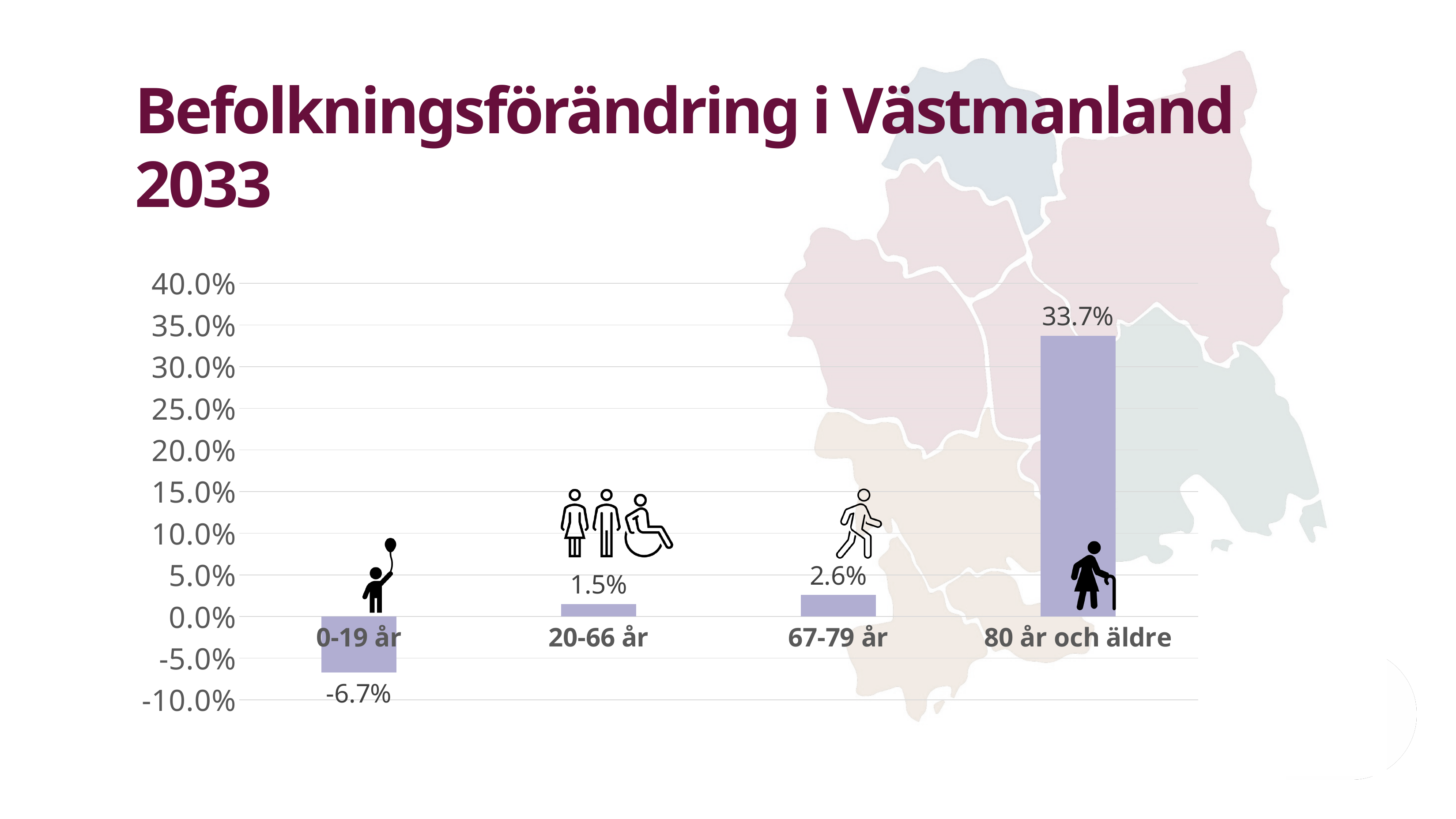
What is the difference between the values for 80 år och äldre and 67-79 år? 31.1% Which is larger, the value for 20-66 år or the value for 67-79 år? 67-79 år What is the value for the 80 år och äldre age group? 33.7% What is the value for the 67-79 år age group? 2.6% Is the value for 80 år och äldre greater or less than 30.0%? greater What kind of chart is shown on the slide? bar chart What is the value for the 20-66 år age group? 1.5% What is the value for the 0-19 år age group? -6.7% Which age group has the lowest value? 0-19 år How many age groups are shown in the chart? 4 What is the title of the slide? Befolkningsförändring i Västmanland 2033 Which age group has the highest value? 80 år och äldre